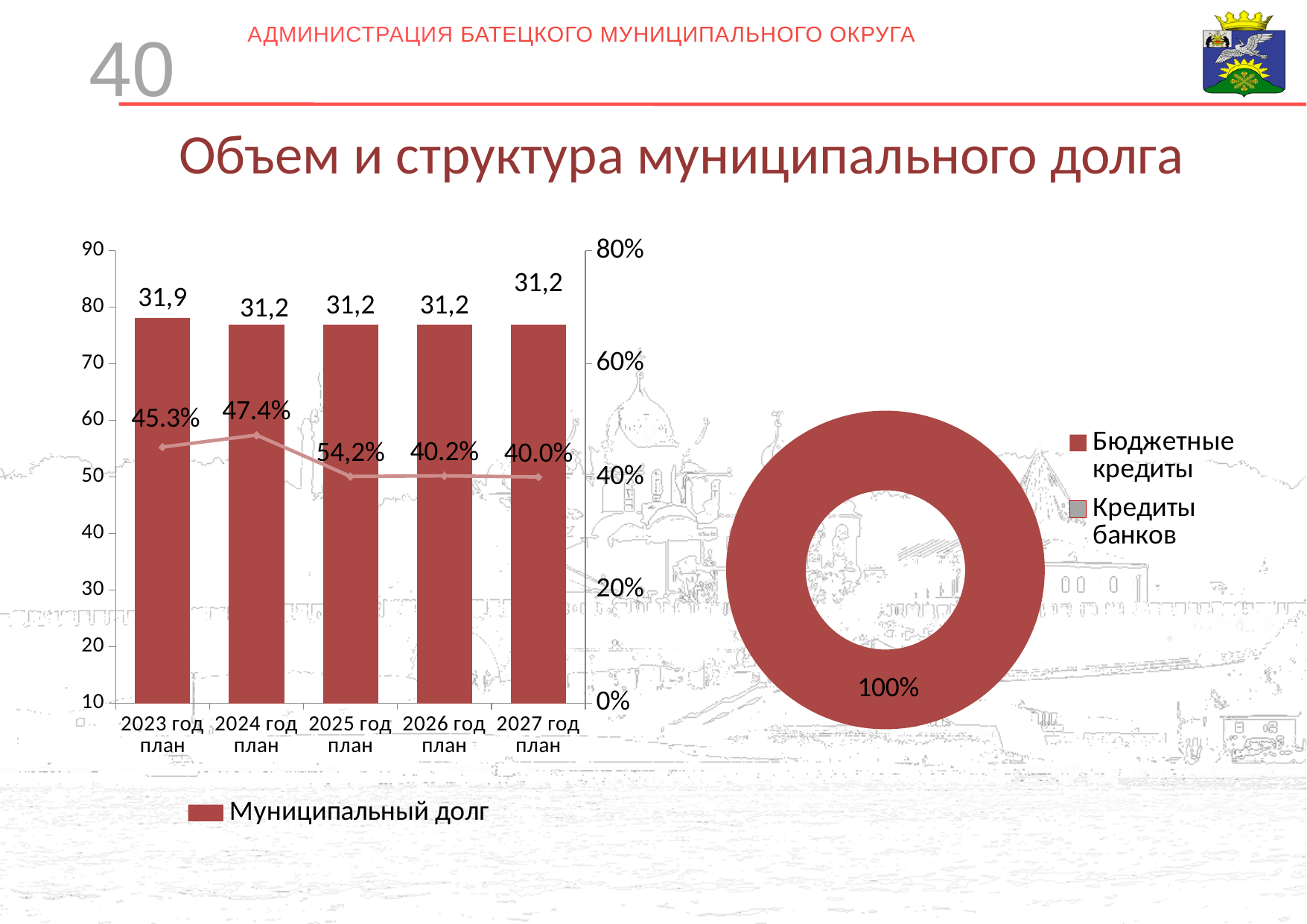
In the bar chart on the left, which year has the highest Муниципальный долг value? 2023 год план How many entries does the legend of the doughnut chart on the right list? 2 In the bar chart on the left, what percentage is shown on the line for 2025 год план? 54,2% In the bar chart on the left, what is the value of Муниципальный долг for 2024 год план? 31,2 In the doughnut chart on the right, what share is shown for Бюджетные кредиты? 100% In the bar chart on the left, is the line percentage higher for 2024 год план or 2026 год план? 2024 год план In the bar chart on the left, what is the difference between the Муниципальный долг values for 2023 год план and 2027 год план? 0,7 In the bar chart on the left, what is the value of Муниципальный долг for 2023 год план? 31,9 In the bar chart on the left, what percentage is shown on the line for 2027 год план? 40.0% In the bar chart on the left, which year has the lowest percentage on the line? 2027 год план How many years are shown on the x axis of the bar chart on the left? 5